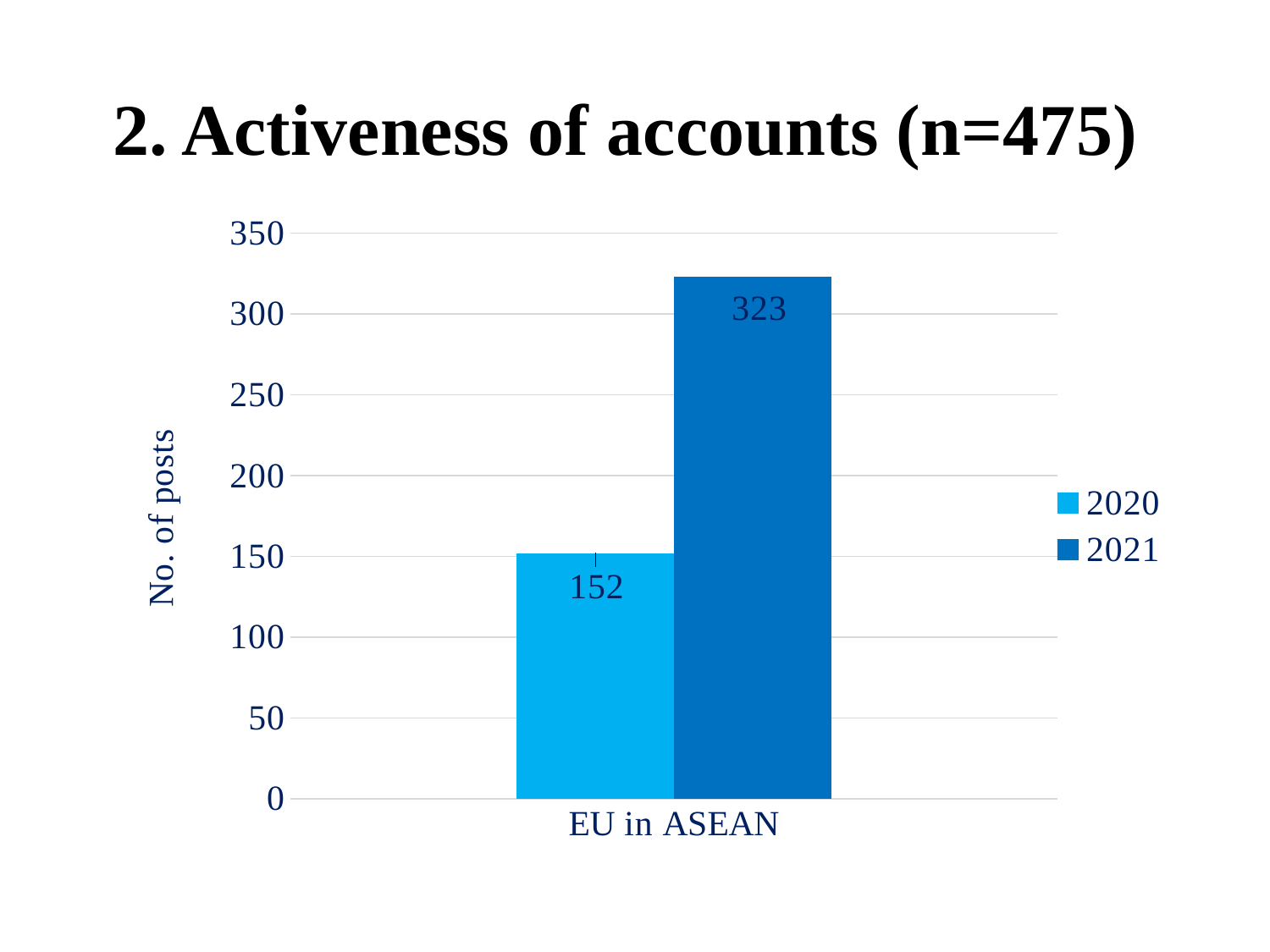
Is the number of posts in 2020 larger or smaller than in 2021? smaller What kind of chart is shown on the slide? bar chart How many series does the legend list? 2 What is the difference between the number of posts in 2021 and 2020 for EU in ASEAN? 171 How many categories are shown on the x axis? 1 Which year has the higher number of posts for EU in ASEAN? 2021 What is the number of posts for EU in ASEAN in 2021? 323 Is the value for 2021 greater or less than 300? greater What is the number of posts for EU in ASEAN in 2020? 152 What is the label of the y axis? No. of posts Is the value for 2020 greater or less than 200? less Which year has the lower number of posts for EU in ASEAN? 2020